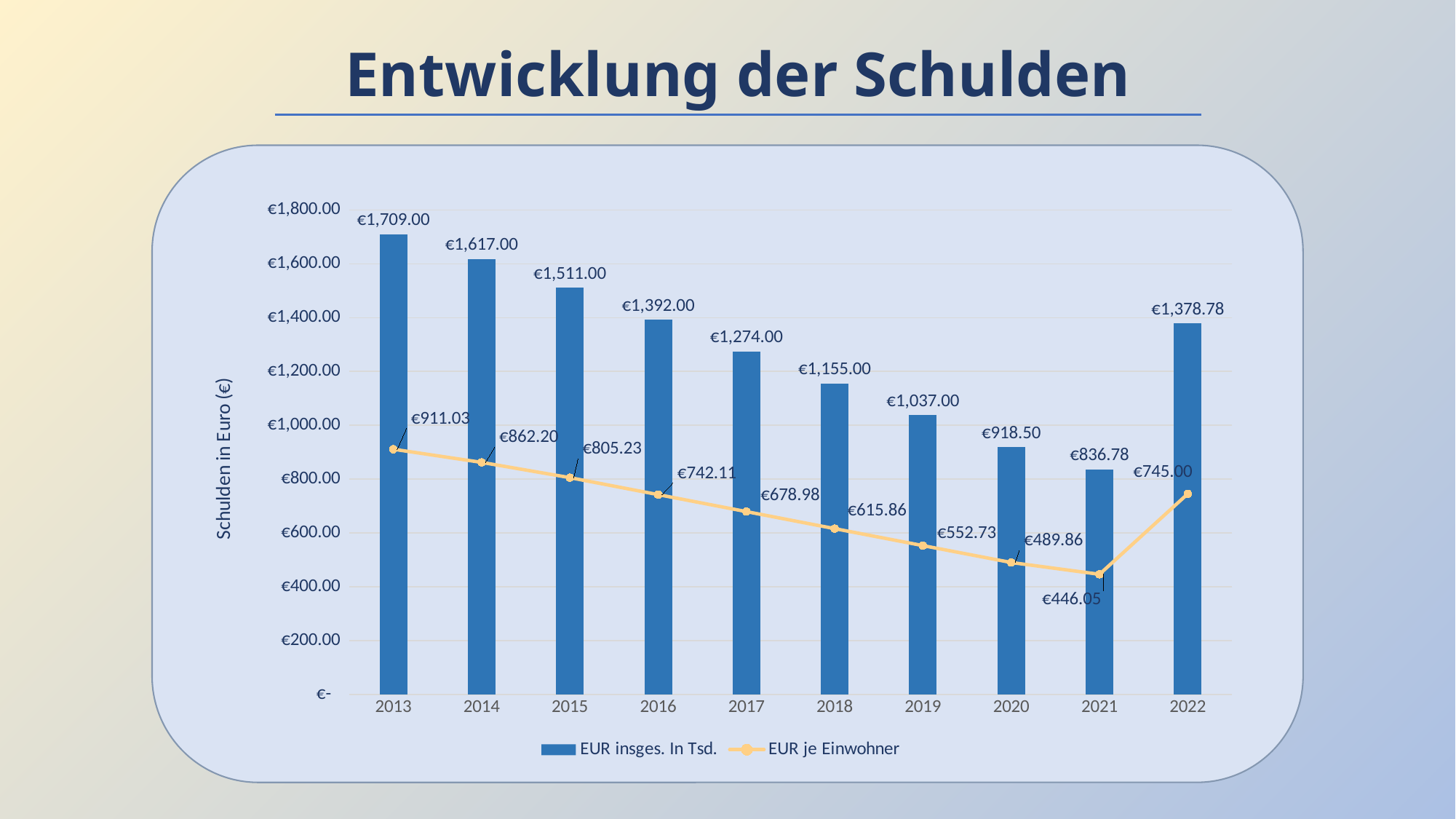
What is the title of the chart slide? Entwicklung der Schulden How does EUR je Einwohner change from 2013 to 2021? It falls What is the value of EUR insges. In Tsd. for 2013? €1,709.00 How many years are shown on the x axis? 10 What is the value of EUR insges. In Tsd. for 2022? €1,378.78 What is the value of EUR je Einwohner for 2021? €446.05 What is the difference between the EUR insges. In Tsd. values for 2013 and 2014? €92.00 Which year has the highest value for EUR je Einwohner? 2013 Which year has the lowest value for EUR insges. In Tsd.? 2021 How many series does the legend list? 2 Which is larger: EUR insges. In Tsd. for 2022 or for 2017? 2022 By how much did EUR je Einwohner increase from 2021 to 2022? €298.95